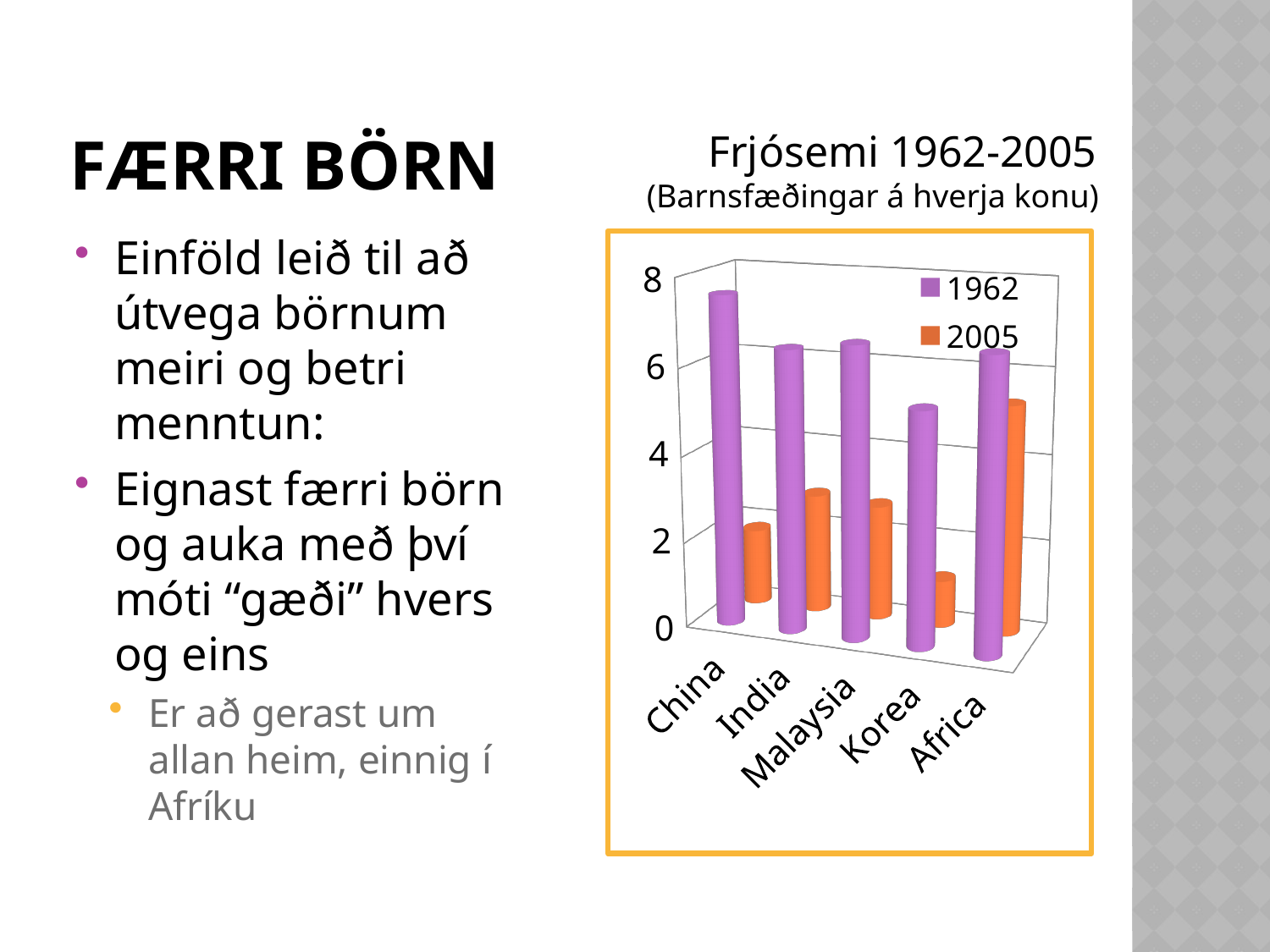
How many series does the chart legend list? 2 Which country has the highest value for 1962? China What is the title of the chart? Frjósemi 1962-2005 (Barnsfæðingar á hverja konu) Which country has the lowest value for 2005? Korea What kind of chart is shown on the slide? bar chart Is the 1962 value for China greater or less than 6? greater Which is larger: the 2005 value for Africa or the 2005 value for China? Africa Is the 2005 value for Africa greater or less than 4? greater Which country has the highest value for 2005? Africa How many countries are shown on the x axis of the chart? 5 Is the 1962 value for Korea greater or less than 4? greater